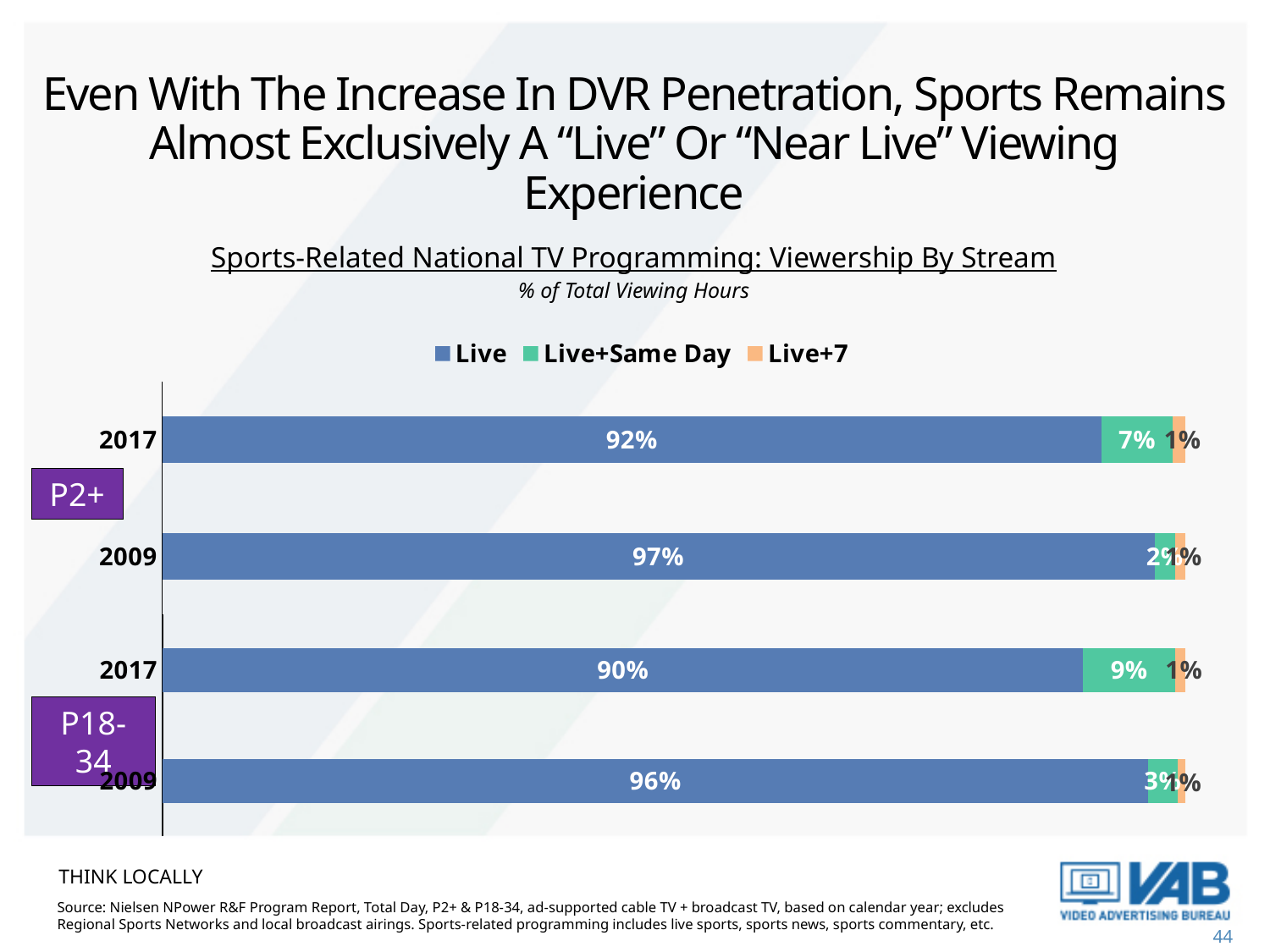
What type of chart is shown on the slide? Stacked bar chart What is the Live+Same Day share for P18-34 in 2017? 9% How many series does the legend list? 3 What is the Live share for P18-34 in 2009? 96% What is the Live share for P2+ in 2017? 92% What is the Live+Same Day share for P2+ in 2017? 7% What is the Live share for P2+ in 2009? 97% What is the Live share for P18-34 in 2017? 90% By how many percentage points did the Live share for P2+ fall from 2009 to 2017? 5 percentage points Which bar has the highest Live share? P2+ 2009 Which bar has the lowest Live share? P18-34 2017 Which is larger, the Live+Same Day share for P18-34 in 2017 or for P2+ in 2017? P18-34 in 2017